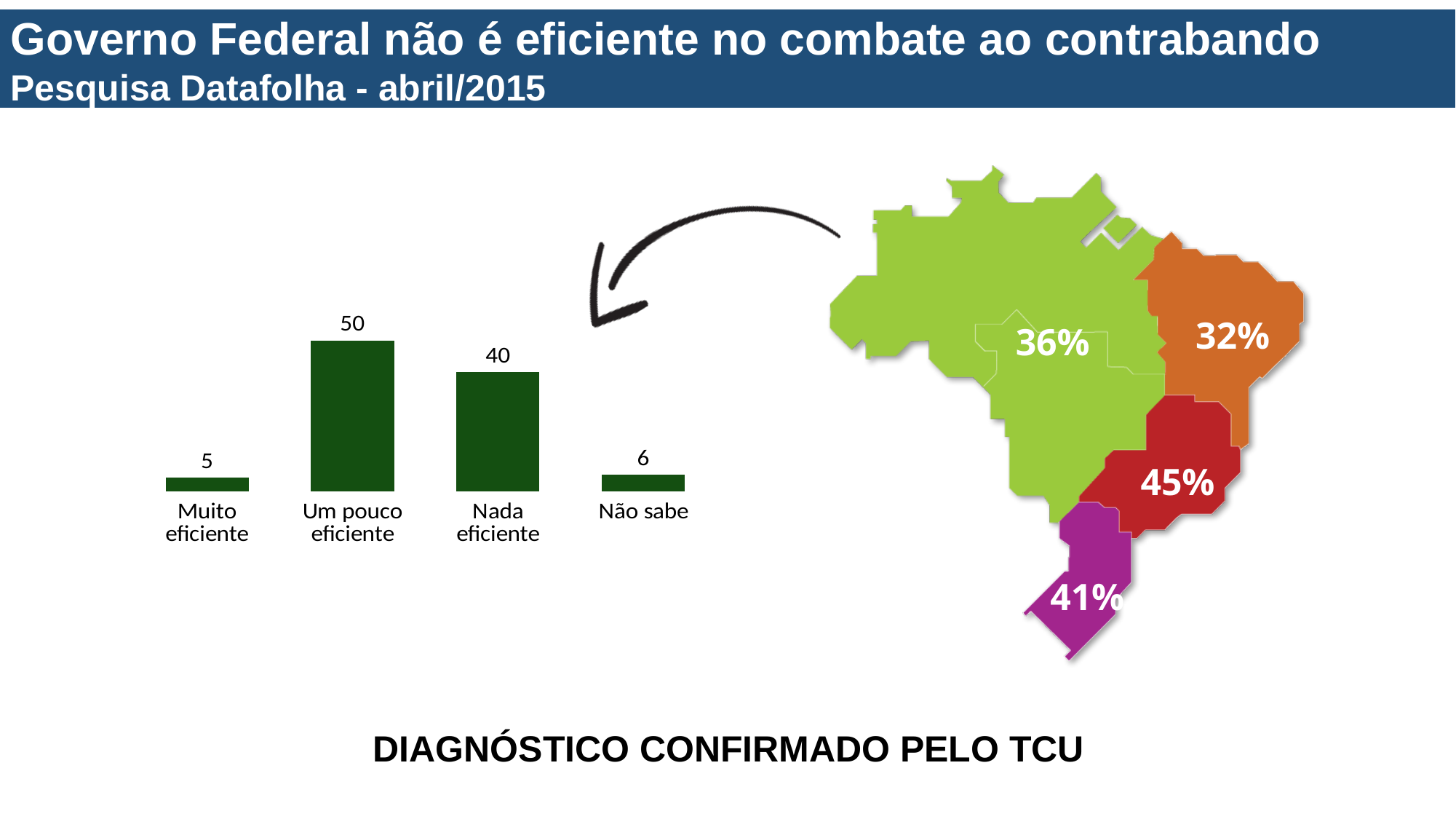
What is the value for "Um pouco eficiente" in the bar chart? 50 Which category has the highest value in the bar chart? Um pouco eficiente What is the difference between the values for "Não sabe" and "Muito eficiente" in the bar chart? 1 What kind of chart is shown on the left of the slide? Bar chart What colour are the bars in the bar chart? Dark green What is the difference between the values for "Um pouco eficiente" and "Nada eficiente" in the bar chart? 10 What is the value for "Muito eficiente" in the bar chart? 5 In the bar chart, which is larger: the value for "Nada eficiente" or the value for "Não sabe"? Nada eficiente How many categories are shown in the bar chart? 4 What is the value for "Nada eficiente" in the bar chart? 40 Which category has the lowest value in the bar chart? Muito eficiente What is the value for "Não sabe" in the bar chart? 6